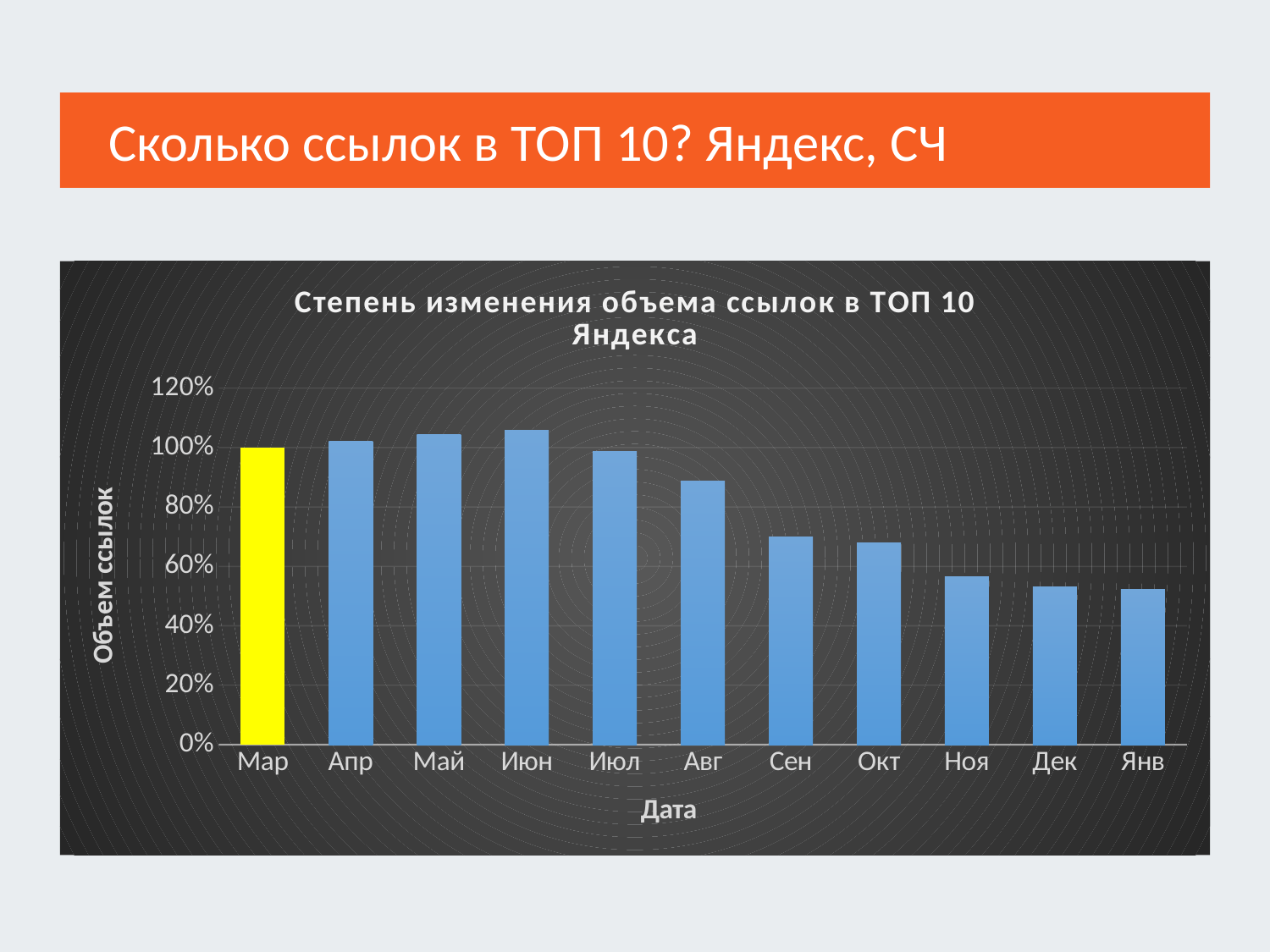
How many months (categories) are shown on the x axis of the chart? 11 What kind of chart is shown on the slide? Bar chart Which month has the highest bar in the chart? Июн Which is larger, the value for Авг or the value for Сен? Авг Which month's bar is coloured yellow instead of blue? Мар What is the value for Мар in the chart? 100% Is the value for Ноя greater or less than 60%? less Is the value for Июн greater or less than 100%? greater Is the value for Сен greater or less than 80%? less Which is larger, the value for Май or the value for Ноя? Май Do the values rise or fall from Июн to Янв along the x axis? Fall